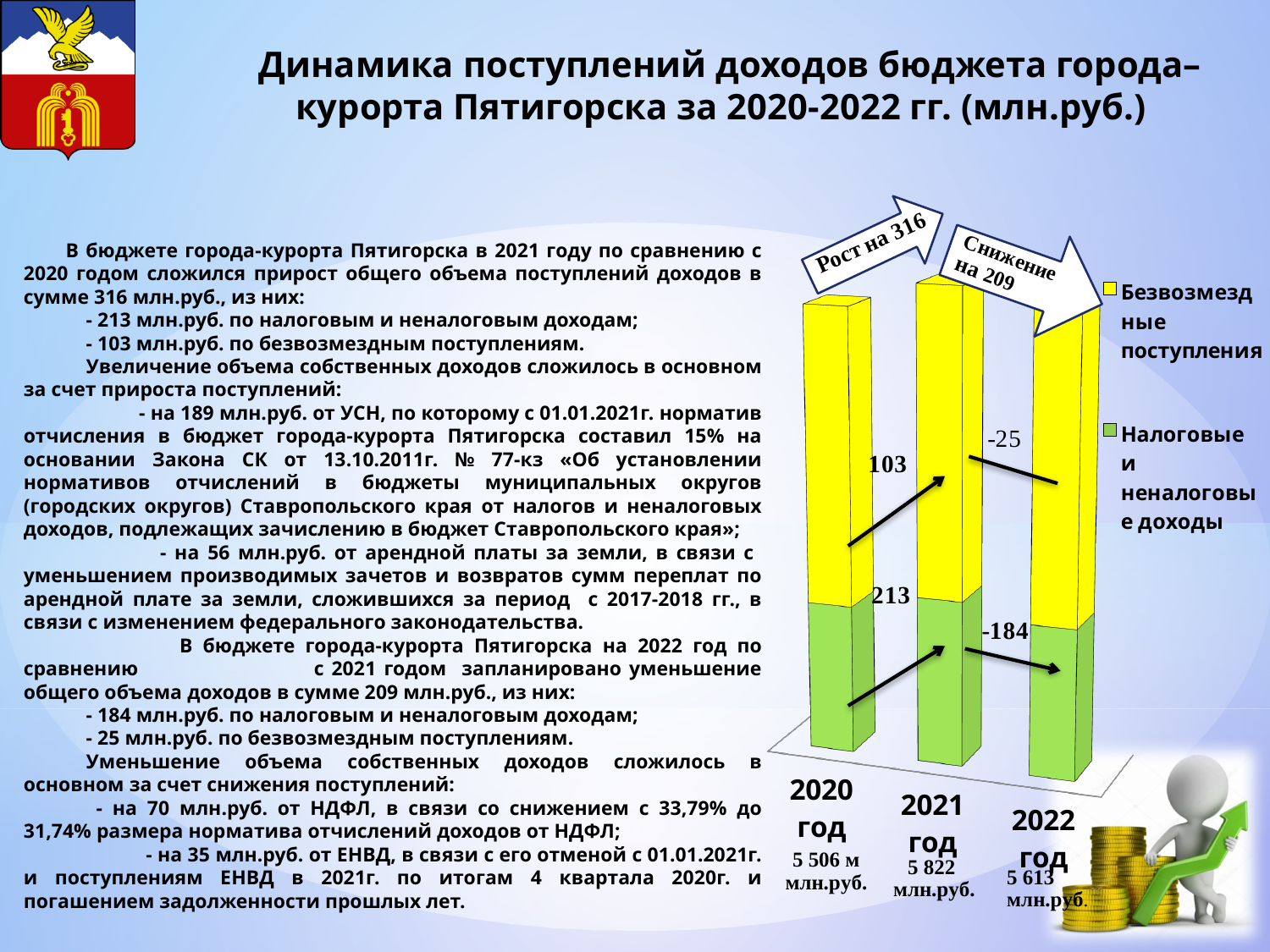
How many years (categories) are shown on the x axis of the chart? 3 Which colour represents Безвозмездные поступления in the legend? Yellow What kind of chart is shown on the slide? Stacked bar chart What total budget revenue (млн.руб.) is printed for 2020 год? 5 506 Which year has the lowest total budget revenue? 2020 год What total budget revenue (млн.руб.) is printed for 2022 год? 5 613 What total budget revenue (млн.руб.) is printed for 2021 год? 5 822 By how much (млн.руб.) does the total for 2021 exceed the total for 2020? 316 Which year has the highest total budget revenue? 2021 год How many series does the chart legend list? 2 Which is larger: the total revenue for 2022 or for 2020? 2022 What change in налоговые и неналоговые доходы is annotated between 2021 and 2022? -184